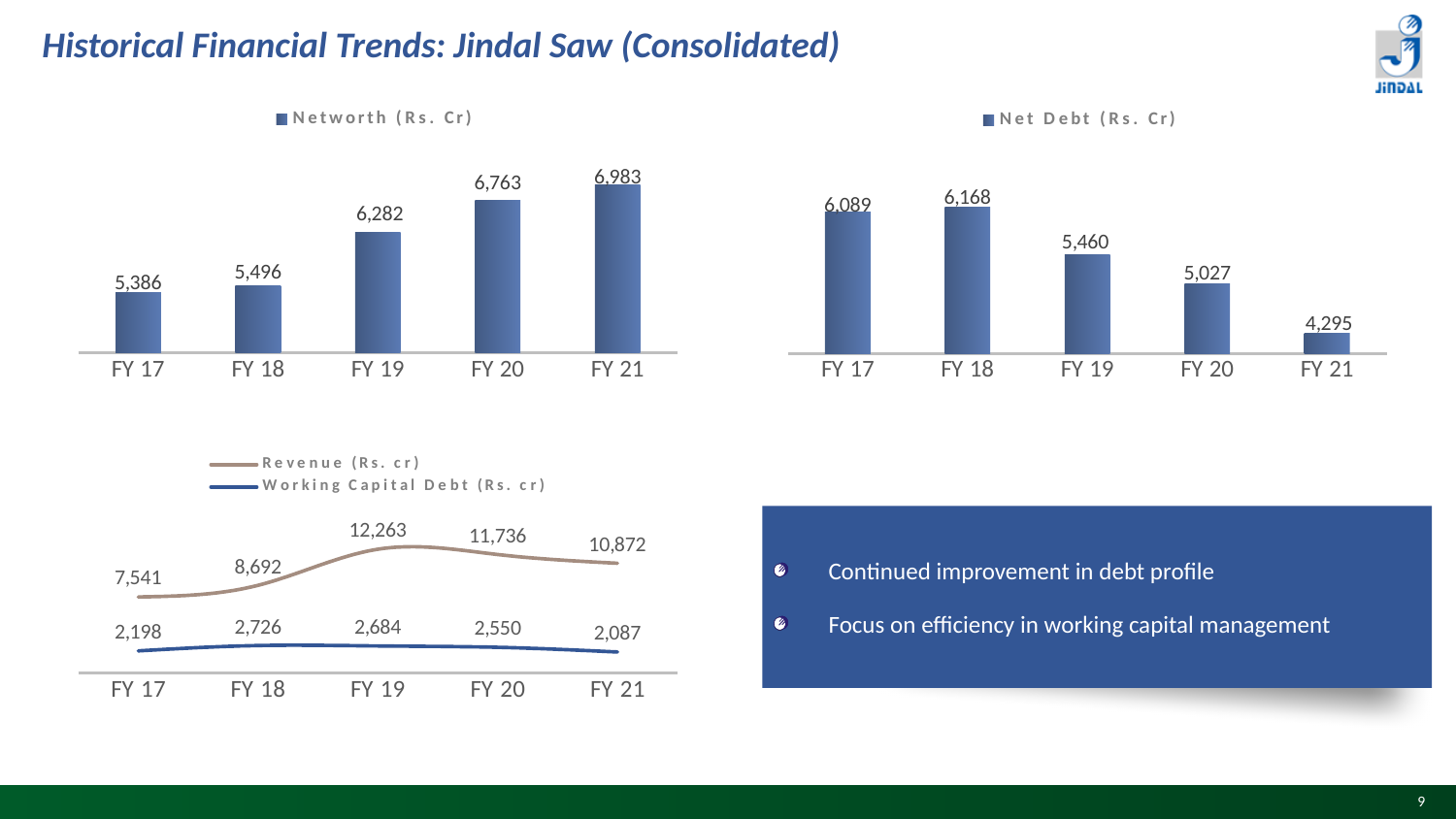
In the bottom-left chart, what is the Working Capital Debt (Rs. cr) value for FY 21? 2,087 In the bottom-left chart, how many series does the legend list? 2 In the Networth (Rs. Cr) chart, what is the difference between FY 21 and FY 17? 1,597 In the Net Debt (Rs. Cr) chart, what is the value for FY 20? 5,027 In the Networth (Rs. Cr) chart, what is the value for FY 19? 6,282 In the Net Debt (Rs. Cr) chart, do the values generally rise or fall from FY 18 to FY 21? fall In the bottom-left chart, what is the Revenue (Rs. cr) value for FY 19? 12,263 In the Networth (Rs. Cr) chart, which year has the highest value? FY 21 In the bottom-left chart, which is larger: Revenue in FY 20 or Revenue in FY 21? FY 20 What kind of chart is the bottom-left chart? line chart In the Net Debt (Rs. Cr) chart, which year has the lowest value? FY 21 In the Net Debt (Rs. Cr) chart, how many years are shown? 5